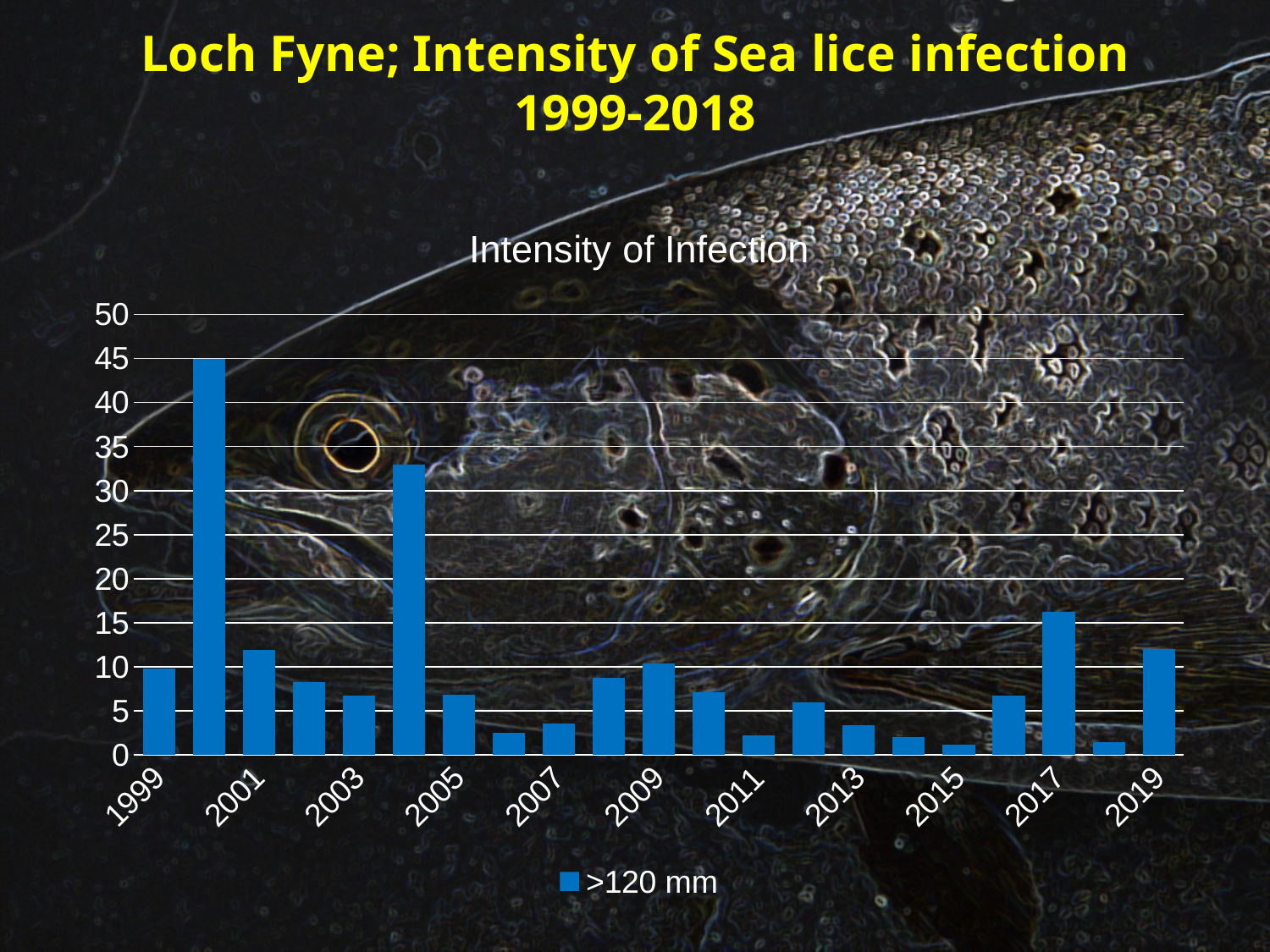
How many series does the legend list? 1 What is the title shown above the chart? Intensity of Infection Is the value for 2004 greater or less than 30? greater Which year has the highest intensity of infection? 2000 What kind of chart is shown on the slide? bar chart How many bars are plotted in the chart? 21 What is the legend entry for the plotted series? >120 mm Which year has the larger value, 2001 or 2002? 2001 Is the value for 2011 greater or less than 5? less Is the value for 2017 greater or less than 10? greater Which year has the larger value, 2004 or 2017? 2004